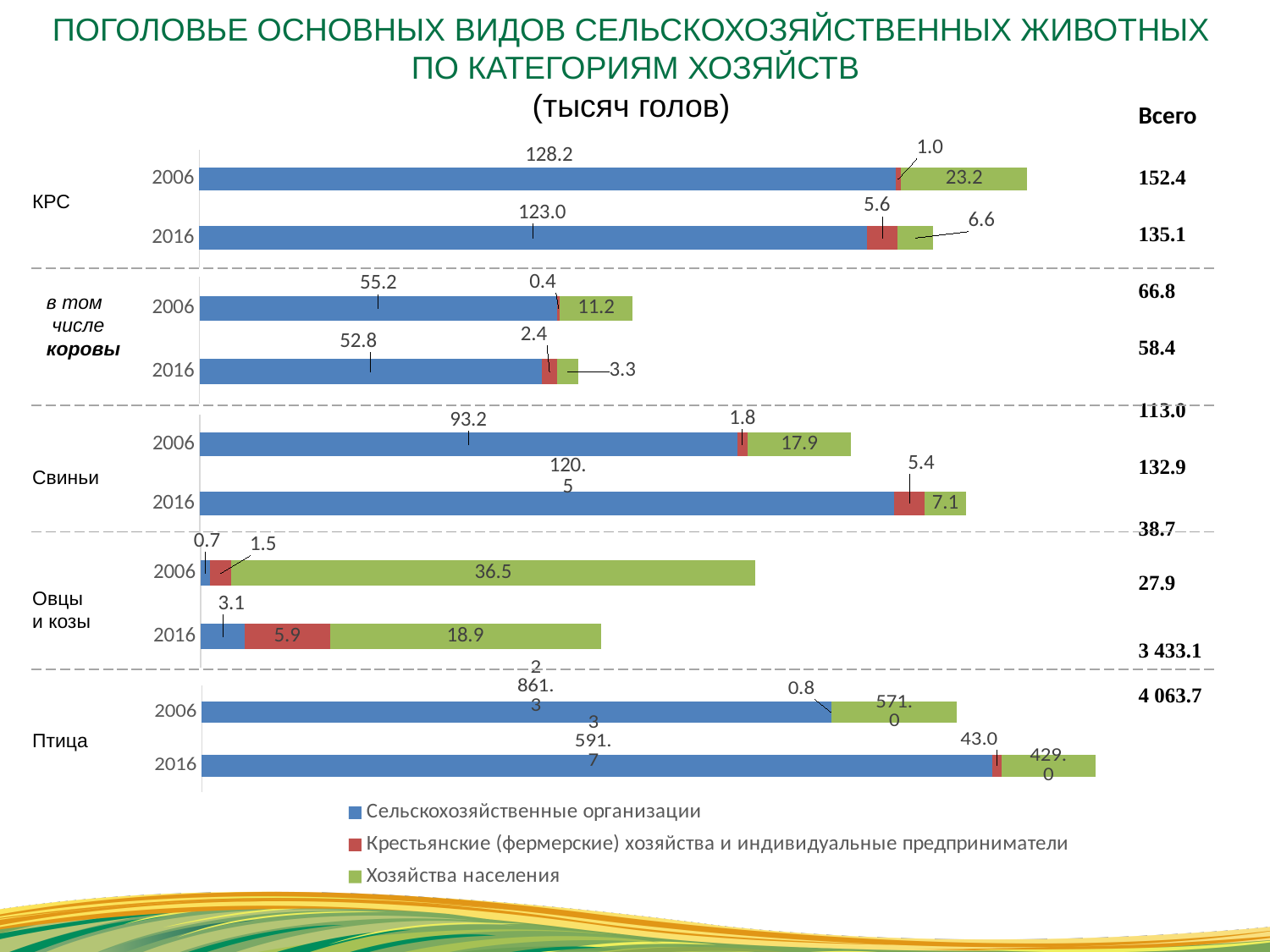
What is the total (Всего) for коровы in 2016? 58.4 What is the value for Сельскохозяйственные организации for КРС in 2006? 128.2 Which series has the highest value for Свиньи in 2006? Сельскохозяйственные организации How many series does the legend list? 3 Which is larger for Овцы и козы in 2016: Крестьянские (фермерские) хозяйства и индивидуальные предприниматели or Хозяйства населения? Хозяйства населения What is the total (Всего) for Птица in 2016? 4 063.7 What is the difference between the Сельскохозяйственные организации values for КРС in 2006 and 2016? 5.2 What type of chart is shown on the slide? stacked bar chart What is the value for Хозяйства населения for КРС in 2016? 6.6 Which series has the lowest value for коровы in 2006? Крестьянские (фермерские) хозяйства и индивидуальные предприниматели What is the value for Крестьянские (фермерские) хозяйства и индивидуальные предприниматели for Свиньи in 2016? 5.4 What is the value for Хозяйства населения for Овцы и козы in 2006? 36.5